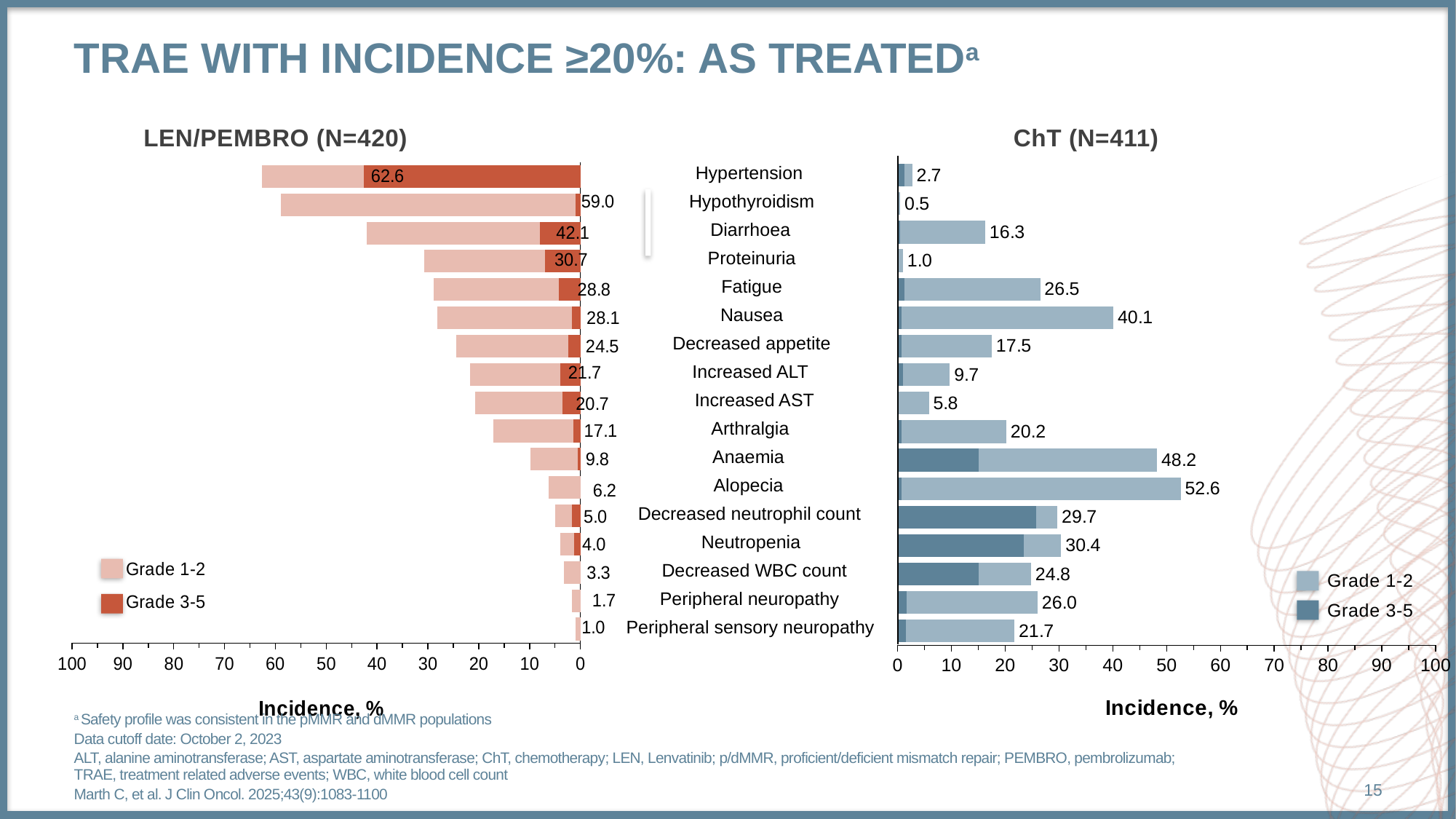
What is the x-axis label of the ChT (N=411) chart? Incidence, % How many series does the legend of the ChT (N=411) chart list? 2 In the LEN/PEMBRO (N=420) chart, which adverse event has the highest total incidence? Hypertension In the ChT (N=411) chart, what is the total incidence of alopecia? 52.6 How many adverse event categories are listed in the LEN/PEMBRO (N=420) chart? 17 What type of chart is the LEN/PEMBRO (N=420) chart? Stacked bar chart In the ChT (N=411) chart, what is the total incidence of nausea? 40.1 In the ChT (N=411) chart, which adverse event has the lowest total incidence? Hypothyroidism In the LEN/PEMBRO (N=420) chart, what is the total incidence of hypertension? 62.6 What is the difference between the total incidence of diarrhoea in the LEN/PEMBRO (N=420) chart and in the ChT (N=411) chart? 25.8 Which is larger: the total incidence of anaemia in the ChT (N=411) chart or the total incidence of hypothyroidism in the LEN/PEMBRO (N=420) chart? Hypothyroidism in LEN/PEMBRO